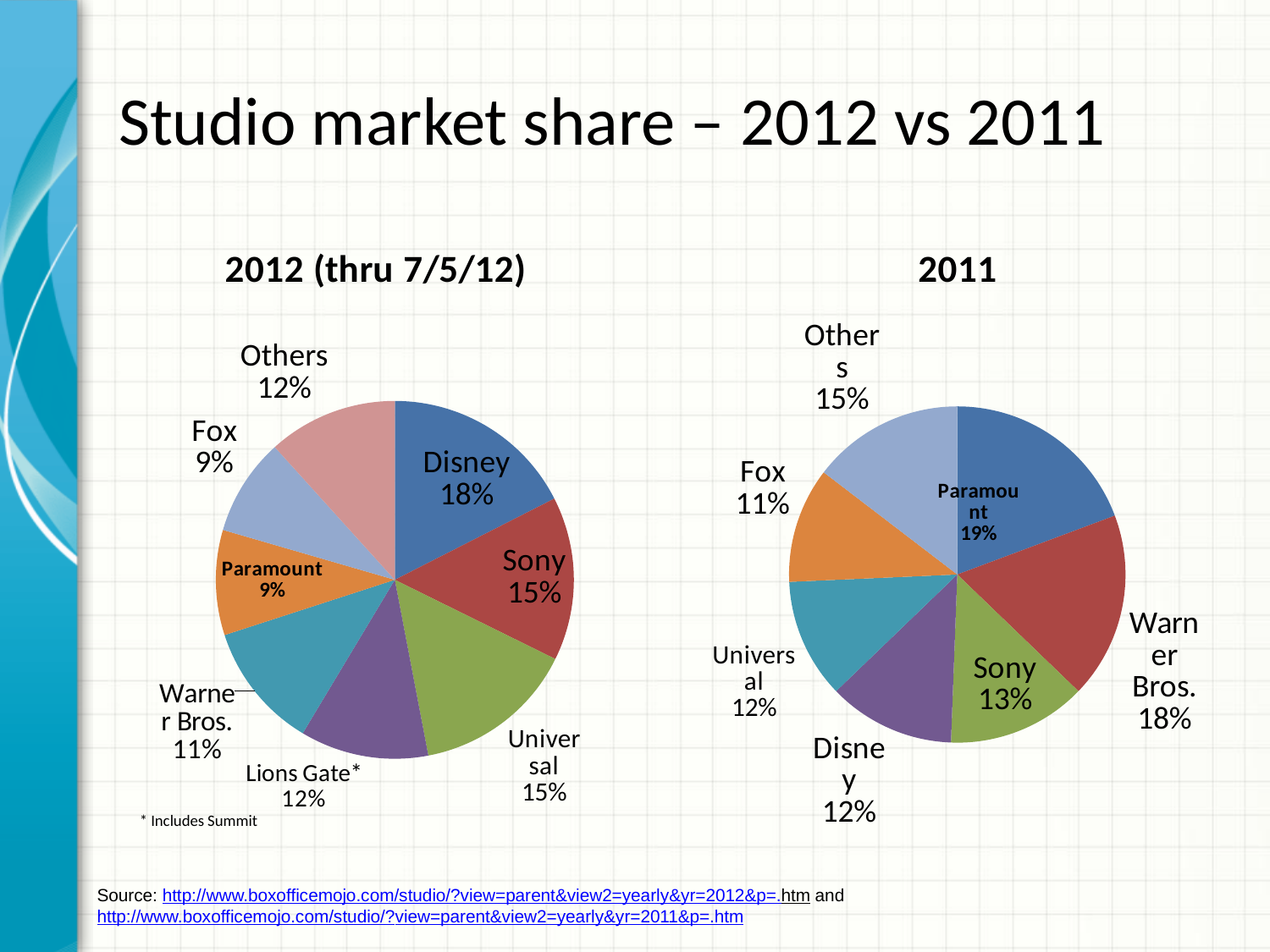
In the 2011 pie chart, which is larger: Warner Bros.' share or Disney's share? Warner Bros. What type of chart is used to show the 2011 studio market share? Pie chart How many slices does the 2012 (thru 7/5/12) pie chart have? 8 In the 2012 (thru 7/5/12) pie chart, what is Disney's market share? 18% In the 2012 (thru 7/5/12) pie chart, which studio has the largest market share? Disney In the 2011 pie chart, which studio has the smallest share? Fox In the 2011 pie chart, which studio has the largest market share? Paramount In the 2011 pie chart, what is the difference between Paramount's share and Sony's share? 6 percentage points In the 2012 (thru 7/5/12) pie chart, which is larger: Sony's share or Warner Bros.' share? Sony How many slices does the 2011 pie chart have? 7 In the 2012 (thru 7/5/12) pie chart, what is the difference between Disney's share and Paramount's share? 9 percentage points In the 2011 pie chart, what is Paramount's market share? 19%